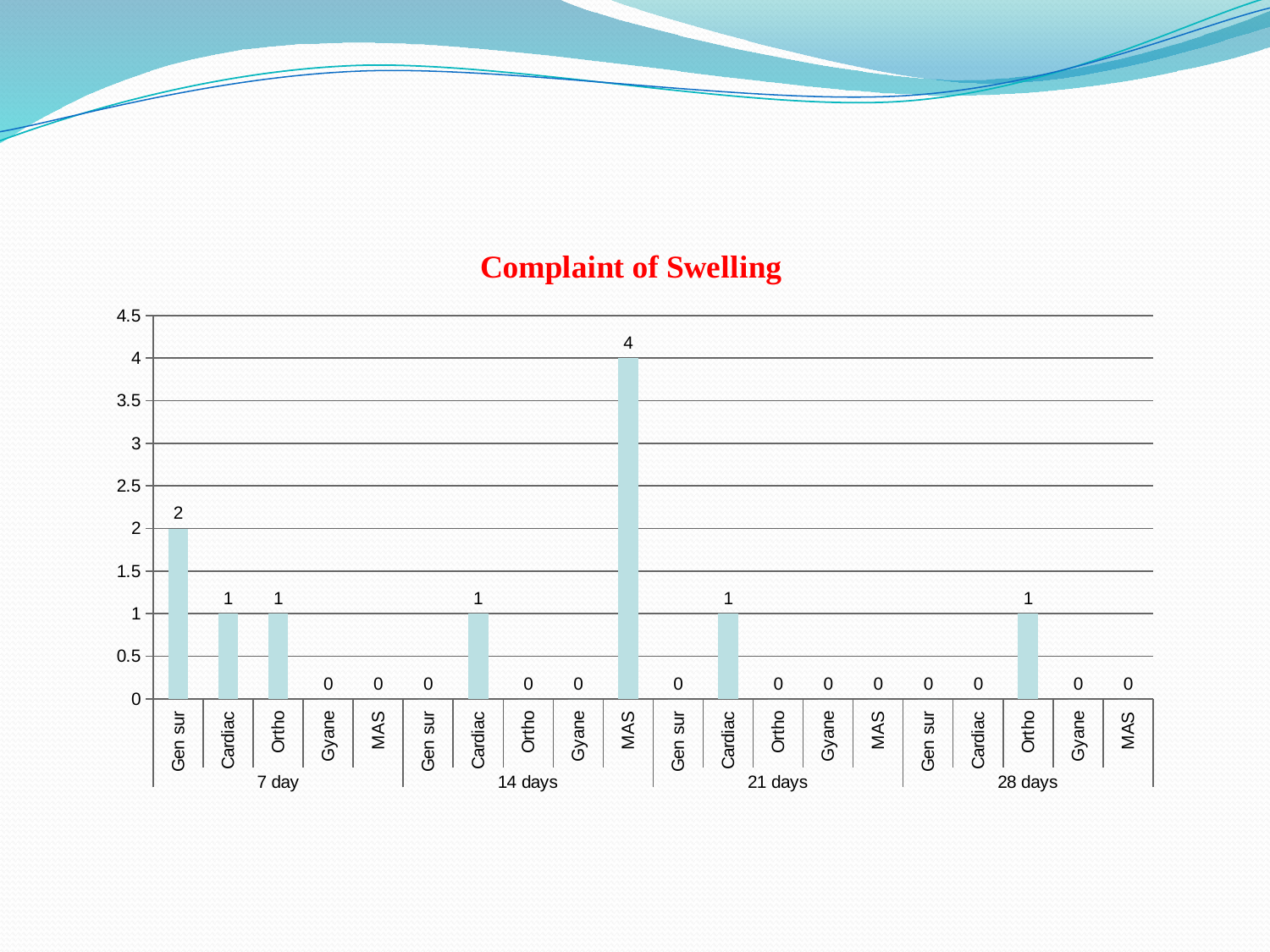
How many time-period groups are shown on the x axis? 4 What kind of chart is shown on the slide? Bar chart How many bars are plotted in the chart? 20 What is the difference between the value for MAS at 14 days and the value for Gen sur at 7 day? 2 What is the value for Gen sur at 7 day? 2 Which is larger: the value for Gen sur at 7 day or the value for Cardiac at 7 day? Gen sur at 7 day What is the value for Cardiac at 21 days? 1 What is the title of the chart? Complaint of Swelling What is the value for Ortho at 28 days? 1 Is the value for MAS at 14 days greater or less than 3? greater Which bar has the highest value in the chart? MAS at 14 days What is the value for MAS at 14 days? 4